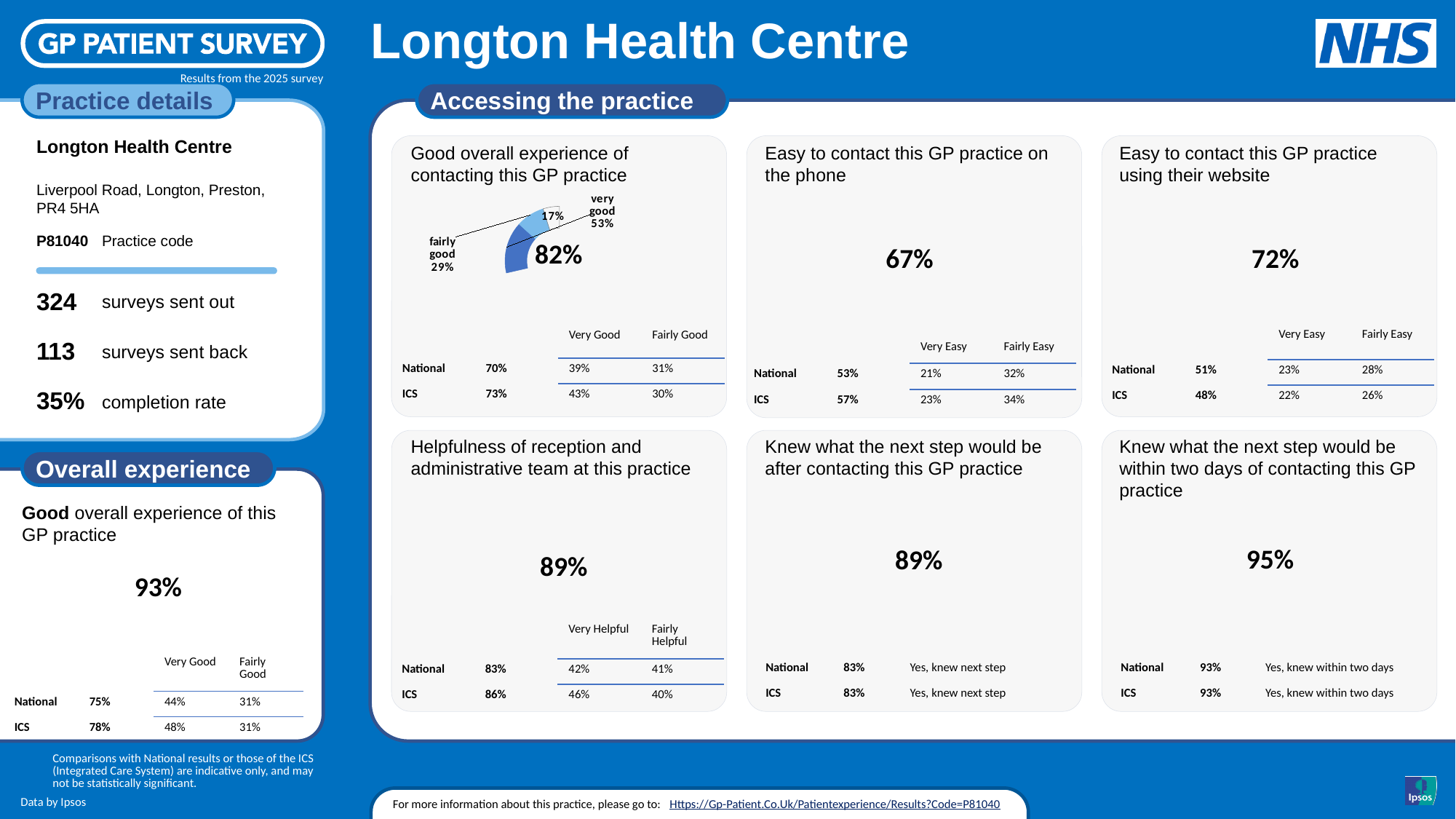
In the 'Good overall experience of contacting this GP practice' chart, what is the difference in percentage points between 'very good' and 'fairly good'? 24 percentage points What is the title of the panel containing the pie chart on the slide? Good overall experience of contacting this GP practice In the 'Good overall experience of contacting this GP practice' chart, what percentage is printed in the centre of the chart? 82% In the 'Good overall experience of contacting this GP practice' chart, which labelled slice is the largest? very good In the 'Good overall experience of contacting this GP practice' chart, which is larger, 'very good' or 'fairly good'? very good In the 'Good overall experience of contacting this GP practice' chart, what is the combined share of 'very good' and 'fairly good'? 82% In the 'Good overall experience of contacting this GP practice' chart, what percentage is shown for 'very good'? 53% What kind of chart is used for 'Good overall experience of contacting this GP practice'? doughnut chart How many slices does the 'Good overall experience of contacting this GP practice' chart have? 3 In the 'Good overall experience of contacting this GP practice' chart, what percentage is shown for 'fairly good'? 29%